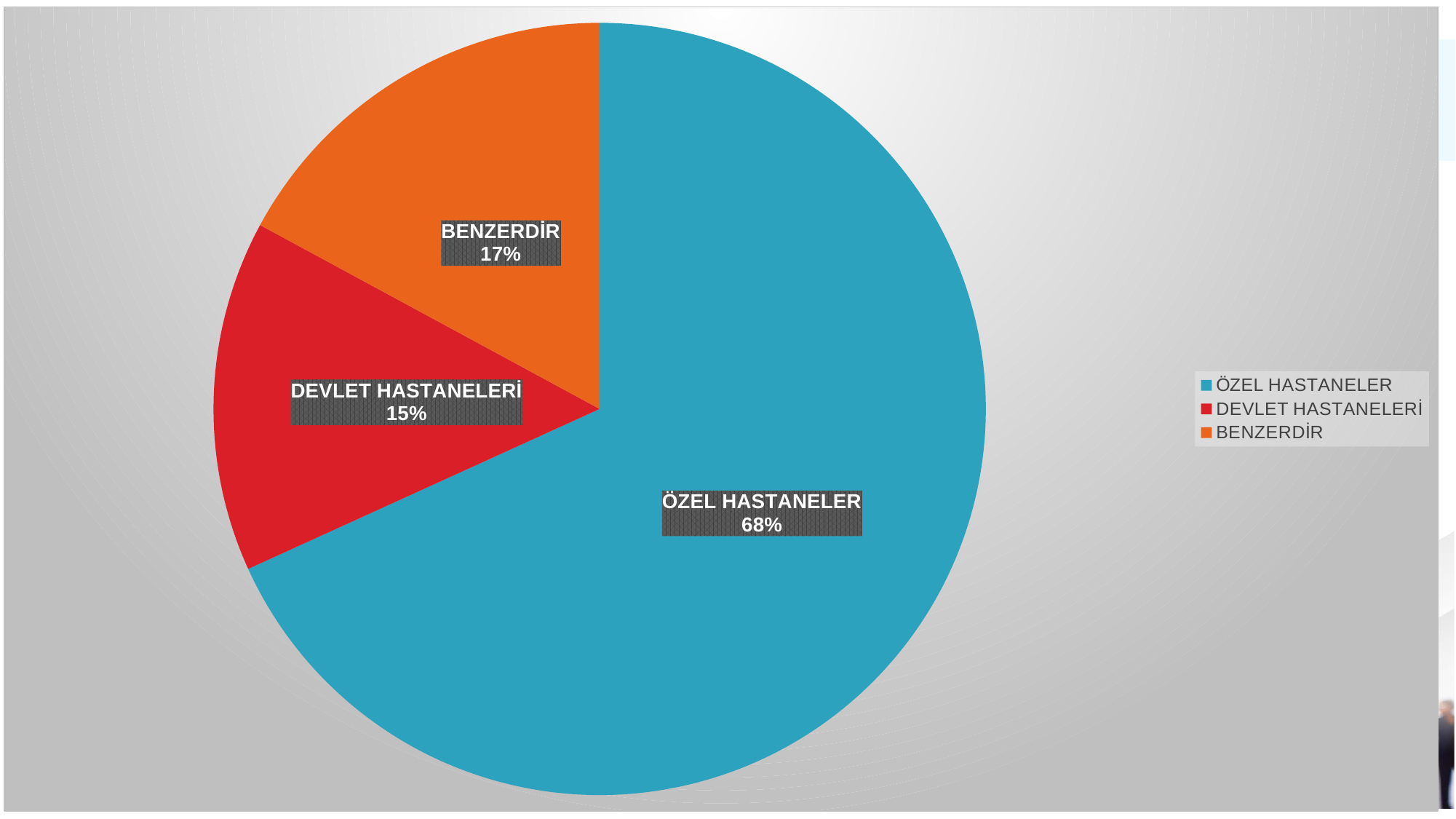
How many slices does the pie chart have? 3 Which category has the smallest share of the pie? DEVLET HASTANELERİ Which category has the largest share of the pie? ÖZEL HASTANELER What percentage is shown for DEVLET HASTANELERİ? 15% What percentage is shown for ÖZEL HASTANELER? 68% What is the difference in percentage points between ÖZEL HASTANELER and BENZERDİR? 51 What colour is the slice for DEVLET HASTANELERİ? red What kind of chart is shown on the slide? pie chart What percentage is shown for BENZERDİR? 17% How many entries does the legend list? 3 Which is larger, the share for ÖZEL HASTANELER or the share for DEVLET HASTANELERİ? ÖZEL HASTANELER What is the difference in percentage points between BENZERDİR and DEVLET HASTANELERİ? 2